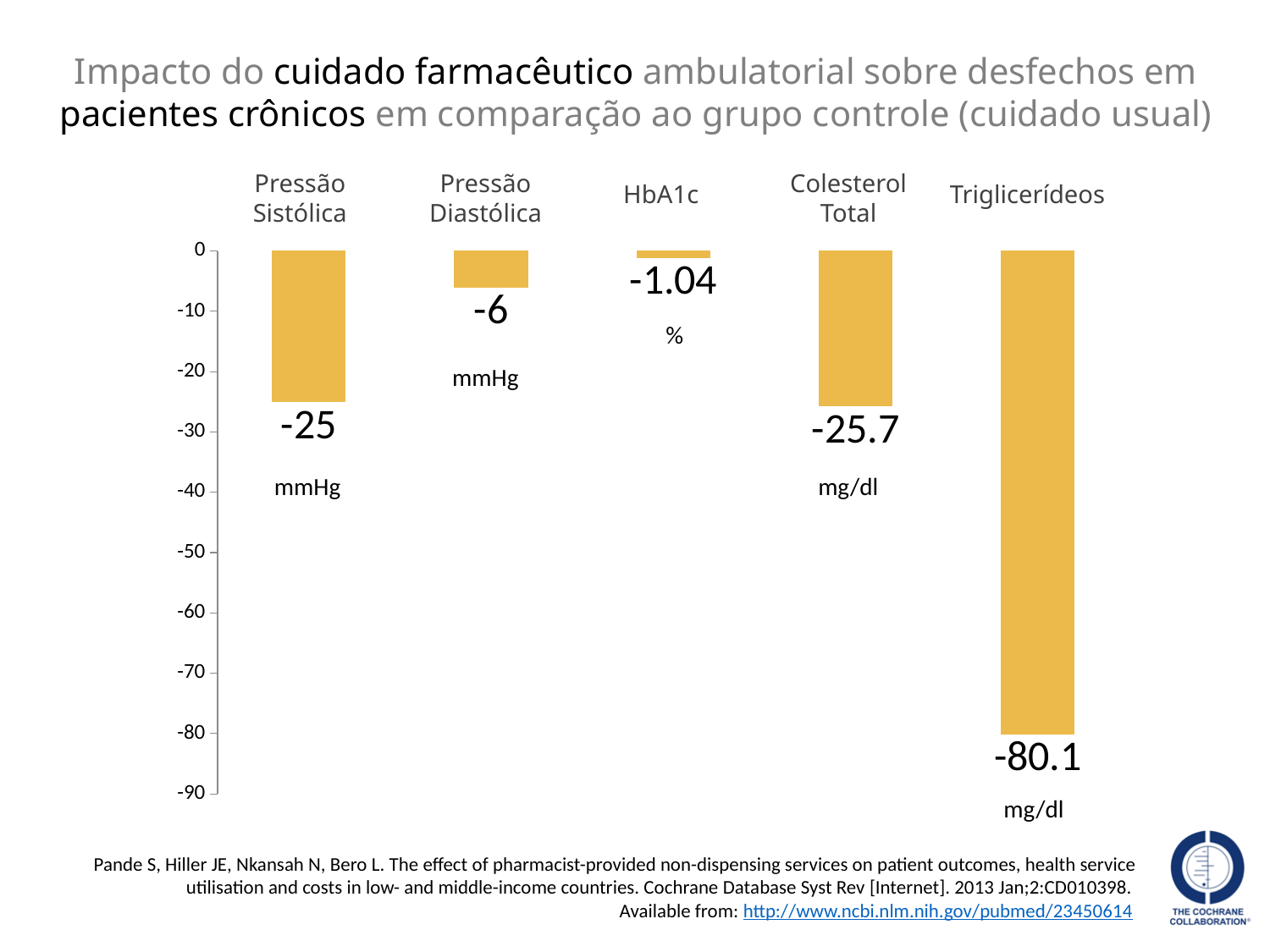
What value is shown for HbA1c? -1.04 % What value is shown for Triglicerídeos? -80.1 mg/dl Which category shows the largest reduction (the lowest value)? Triglicerídeos What is the difference between the values for Pressão Sistólica and Pressão Diastólica? 19 mmHg What value is shown for Pressão Diastólica? -6 mmHg What kind of chart is shown on the slide? bar chart What value is shown for Colesterol Total? -25.7 mg/dl What is the difference between the values for Triglicerídeos and Colesterol Total? 54.4 mg/dl Is the value for Triglicerídeos greater or less than -70? less What value is shown for Pressão Sistólica? -25 mmHg How many categories are plotted in the chart? 5 Which category shows the smallest reduction (the value closest to zero)? HbA1c